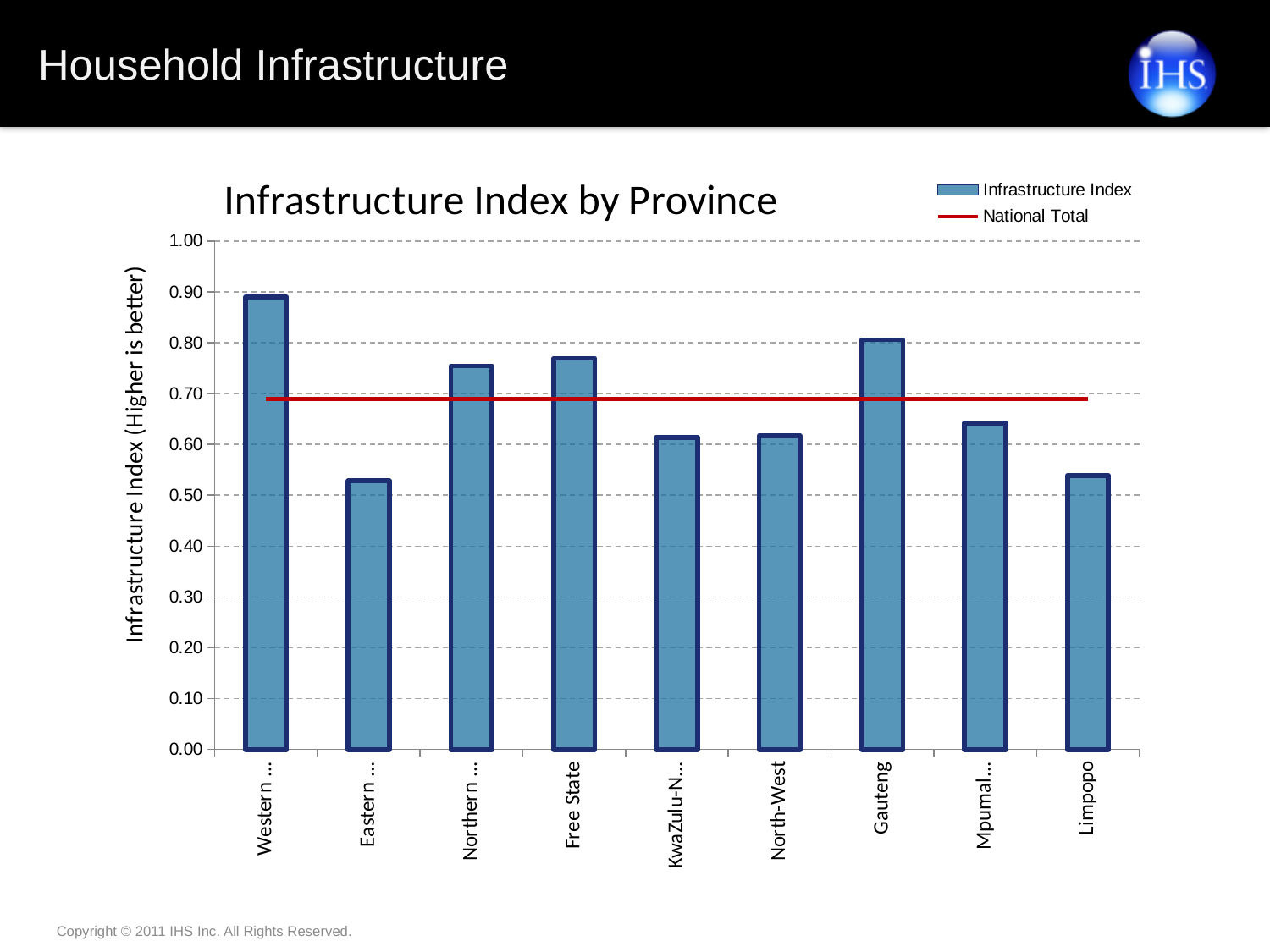
Which has a higher Infrastructure Index, Gauteng or Free State? Gauteng Which has a lower Infrastructure Index, Limpopo or Gauteng? Limpopo Is the value for North-West greater or less than 0.70? less Is the value for Gauteng greater or less than 0.70? greater What type of chart is shown on the slide? Bar chart How many series does the legend list? 2 Is the value for Free State greater or less than 0.70? greater How many provinces (bars) are plotted in the chart? 9 What is the title of the chart? Infrastructure Index by Province Which has a higher Infrastructure Index, Free State or North-West? Free State What does the red horizontal line in the chart represent, according to the legend? National Total